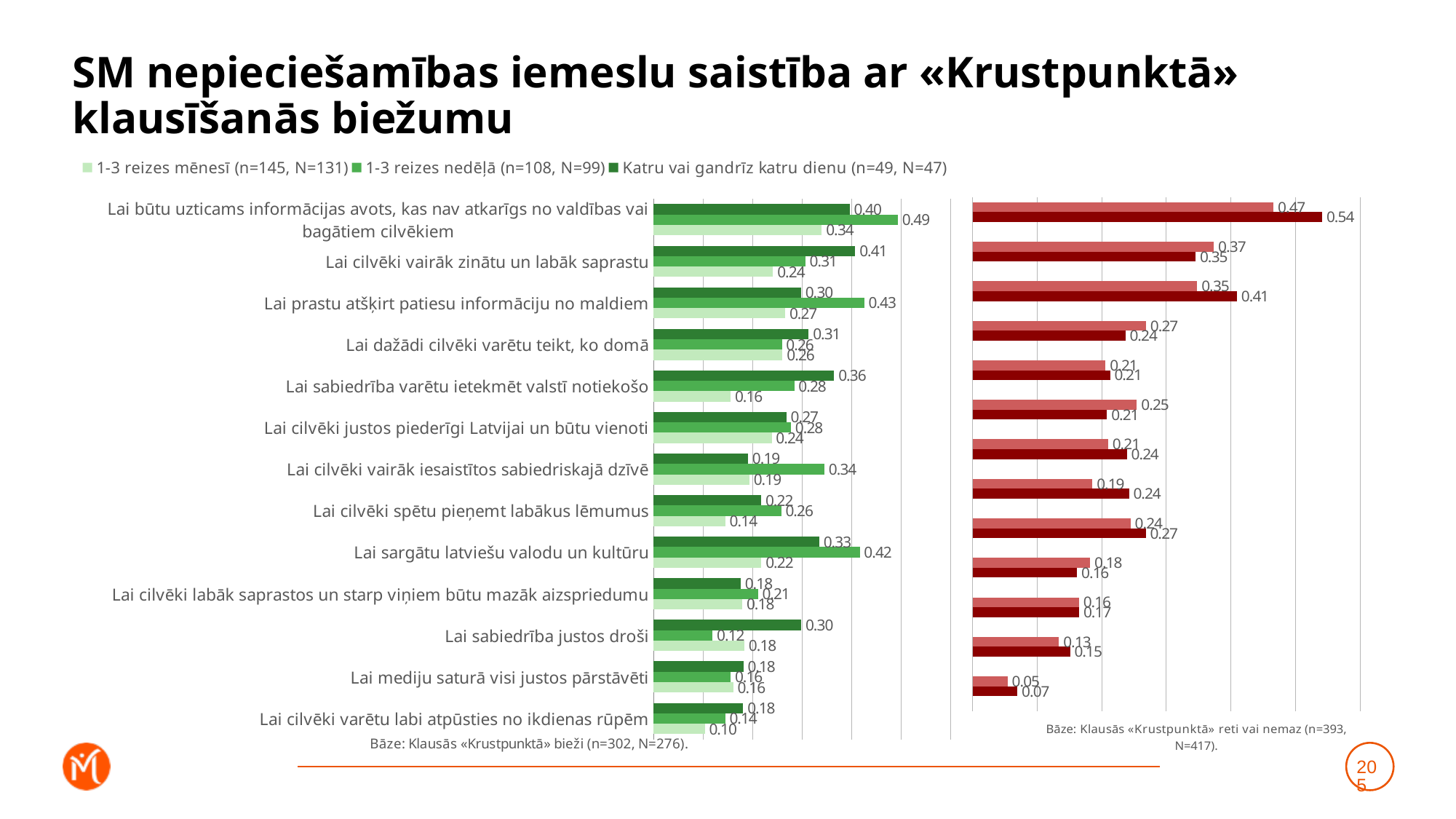
In the left (green) chart, which category has the highest value in the '1-3 reizes nedēļā (n=108, N=99)' series? Lai būtu uzticams informācijas avots, kas nav atkarīgs no valdības vai bagātiem cilvēkiem How many series does the legend of the left (green) chart list? 3 What kind of chart is the left (green) chart? Bar chart In the left (green) chart, what is the difference between the '1-3 reizes nedēļā' and '1-3 reizes mēnesī' values for 'Lai būtu uzticams informācijas avots, kas nav atkarīgs no valdības vai bagātiem cilvēkiem'? 0.15 In the left (green) chart, what is the value for 'Lai sargātu latviešu valodu un kultūru' in the '1-3 reizes nedēļā (n=108, N=99)' series? 0.42 What base note is printed under the left (green) chart? Bāze: Klausās «Krustpunktā» bieži (n=302, N=276). In the left (green) chart, what is the value for 'Lai sabiedrība justos droši' in the 'Katru vai gandrīz katru dienu (n=49, N=47)' series? 0.30 In the left (green) chart, which category has the lowest value in the '1-3 reizes mēnesī (n=145, N=131)' series? Lai cilvēki varētu labi atpūsties no ikdienas rūpēm In the right (red) chart, what is the highest value shown? 0.54 How many categories are shown in the left (green) chart? 13 In the left (green) chart, for 'Lai prastu atšķirt patiesu informāciju no maldiem', which series has the larger value: '1-3 reizes nedēļā' or 'Katru vai gandrīz katru dienu'? 1-3 reizes nedēļā In the left (green) chart, what is the value for 'Lai sabiedrība varētu ietekmēt valstī notiekošo' in the '1-3 reizes mēnesī (n=145, N=131)' series? 0.16